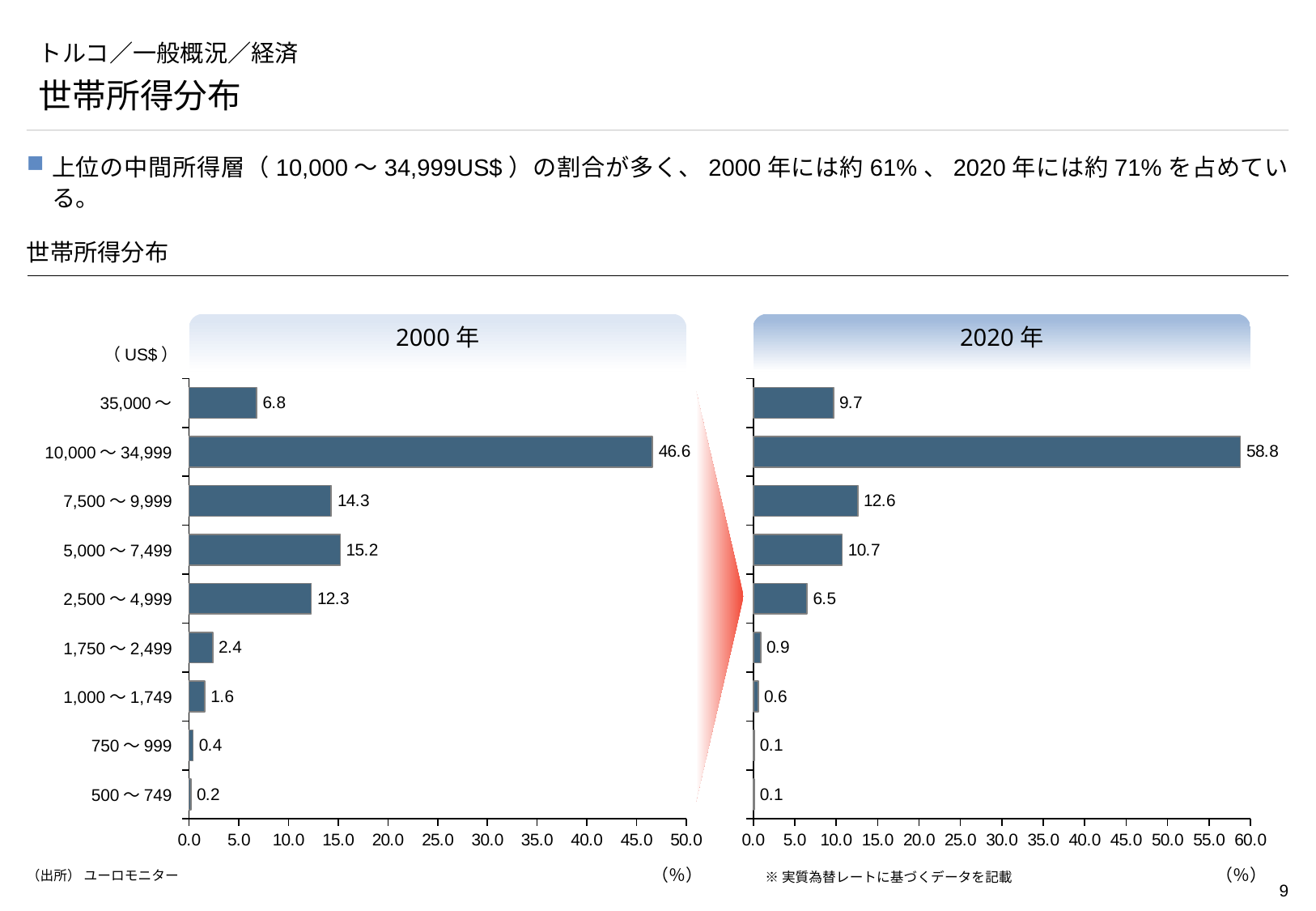
What is the difference between the 10,000～34,999 value in the 2020年 chart and the same band in the 2000年 chart? 12.2 In the 2020年 chart, what is the value for the 35,000～ income band? 9.7 How many income bands are shown in the 2000年 chart? 9 In the 2000年 chart, which income band has the lowest value? 500～749 In the 2000年 chart, which is larger: the value for 5,000～7,499 or the value for 7,500～9,999? 5,000～7,499 In the 2000年 chart, what is the value for the 2,500～4,999 income band? 12.3 In the 2020年 chart, what is the difference between the values for 7,500～9,999 and 5,000～7,499? 1.9 In the 2020年 chart, which income band has the highest value? 10,000～34,999 What is the maximum value shown on the x axis of the 2020年 chart? 60.0 In the 2020年 chart, is the value for 10,000～34,999 greater or less than 55.0? greater What kind of chart is the 2020年 chart? bar chart In the 2000年 chart, what is the value for the 10,000～34,999 income band? 46.6